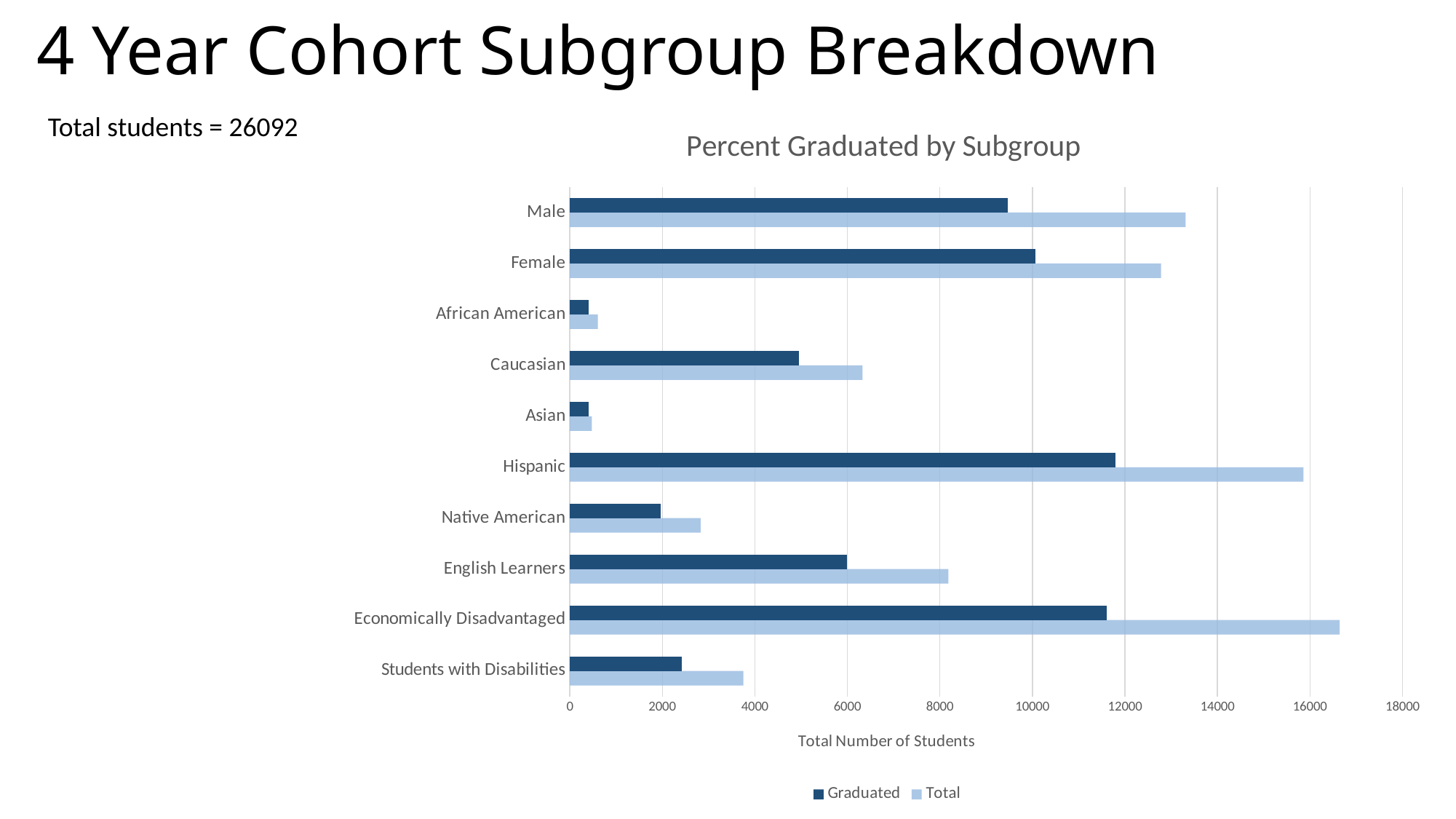
Which is larger, the Graduated value for Female or the Graduated value for Male? Female Is the Graduated value for Caucasian greater or less than 6000? less Which is larger, the Total value for Male or the Total value for Female? Male What kind of chart is shown on the slide? bar chart Is the Total value for Hispanic greater or less than 14000? greater Is the Total value for Economically Disadvantaged greater or less than 16000? greater How many subgroups are listed on the chart's vertical axis? 10 What is the title of the chart's horizontal axis? Total Number of Students How many series does the chart's legend list? 2 Which subgroup has the highest Total value? Economically Disadvantaged